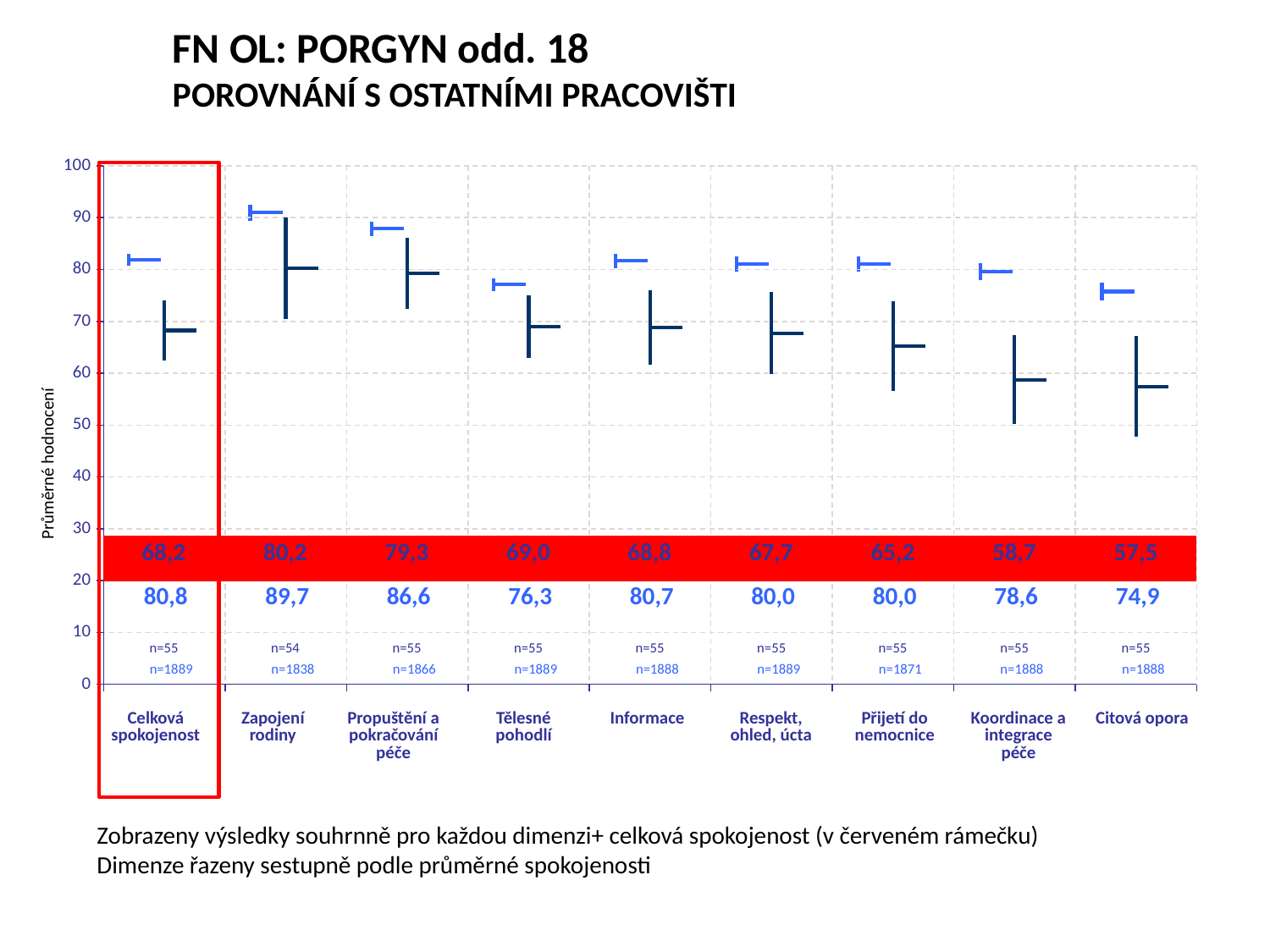
What is the difference between the comparison value (80,8) and the red-band value (68,2) for Celková spokojenost? 12,6 Which has the larger red-band value: Celková spokojenost or Přijetí do nemocnice? Celková spokojenost What is the value shown below the red band (the comparison value) for Tělesné pohodlí? 76,3 Which dimension has the lowest comparison value shown below the red band? Citová opora How many dimensions (categories) are shown along the x axis? 9 What is the label of the y axis? Průměrné hodnocení What is the value shown in the red band for Celková spokojenost? 68,2 Which dimension has the lowest value in the red band? Citová opora Do the red-band values rise or fall from Zapojení rodiny to Citová opora along the x axis? fall What is the value shown in the red band for Koordinace a integrace péče? 58,7 What is the difference between the two values shown for Zapojení rodiny (89,7 and 80,2)? 9,5 Which dimension has the highest value in the red band? Zapojení rodiny